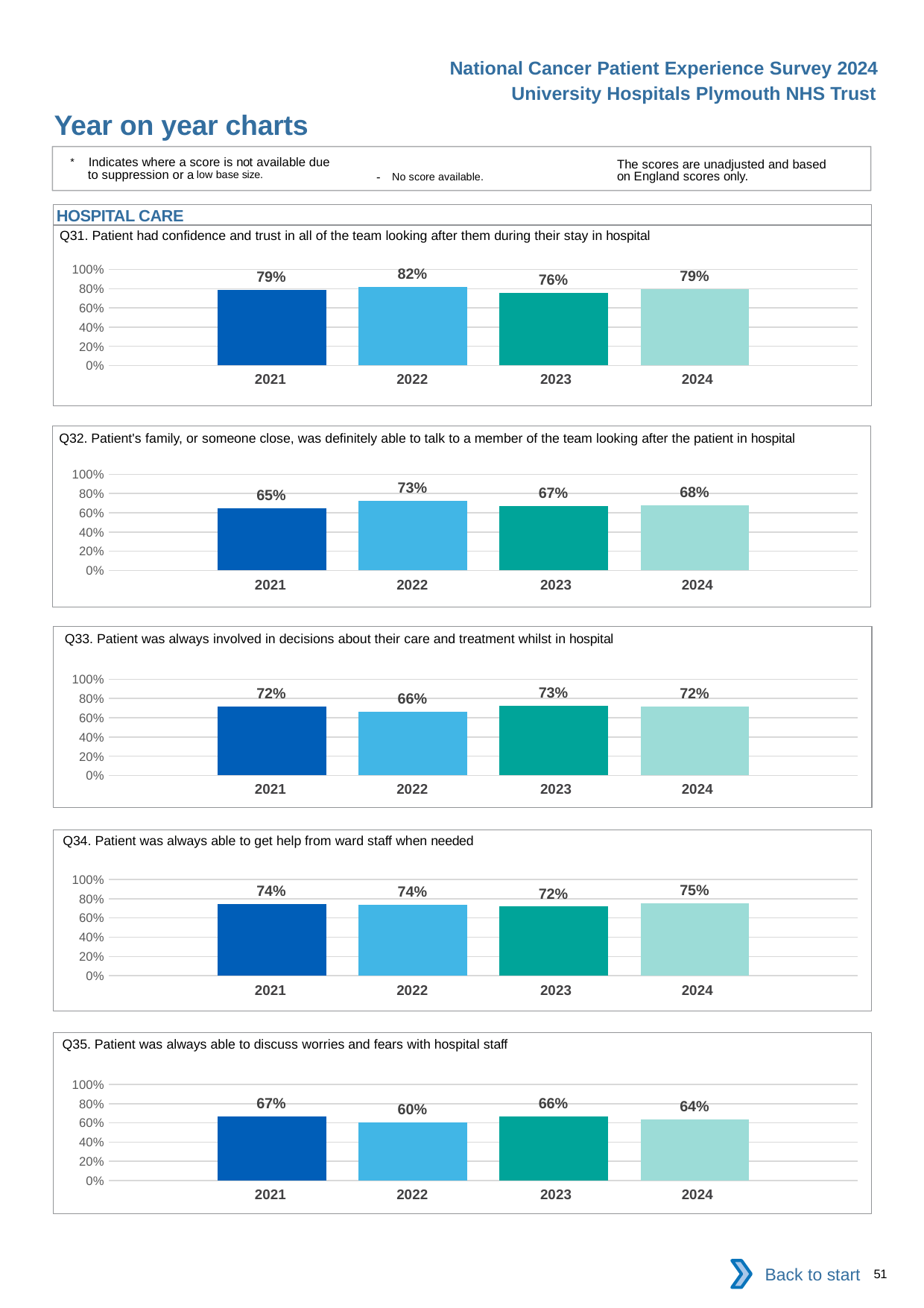
In the Q34 chart, what is the value for 2024? 75% In the Q31 chart, which year has the lowest value? 2023 In the Q35 chart, which year has the lowest value? 2022 In the Q33 chart, what is the value for 2022? 66% In the Q35 chart, what is the difference between the 2021 and 2024 values? 3 percentage points In the Q32 chart, what is the value for 2021? 65% In the Q32 chart, what is the difference between the 2022 and 2021 values? 8 percentage points What kind of chart is the Q35 chart? Bar chart In the Q31 chart, what is the value for 2022? 82% In the Q32 chart, which year has the highest value? 2022 In the Q34 chart, how many years are shown on the x axis? 4 In the Q33 chart, which is larger, the value for 2022 or the value for 2023? 2023